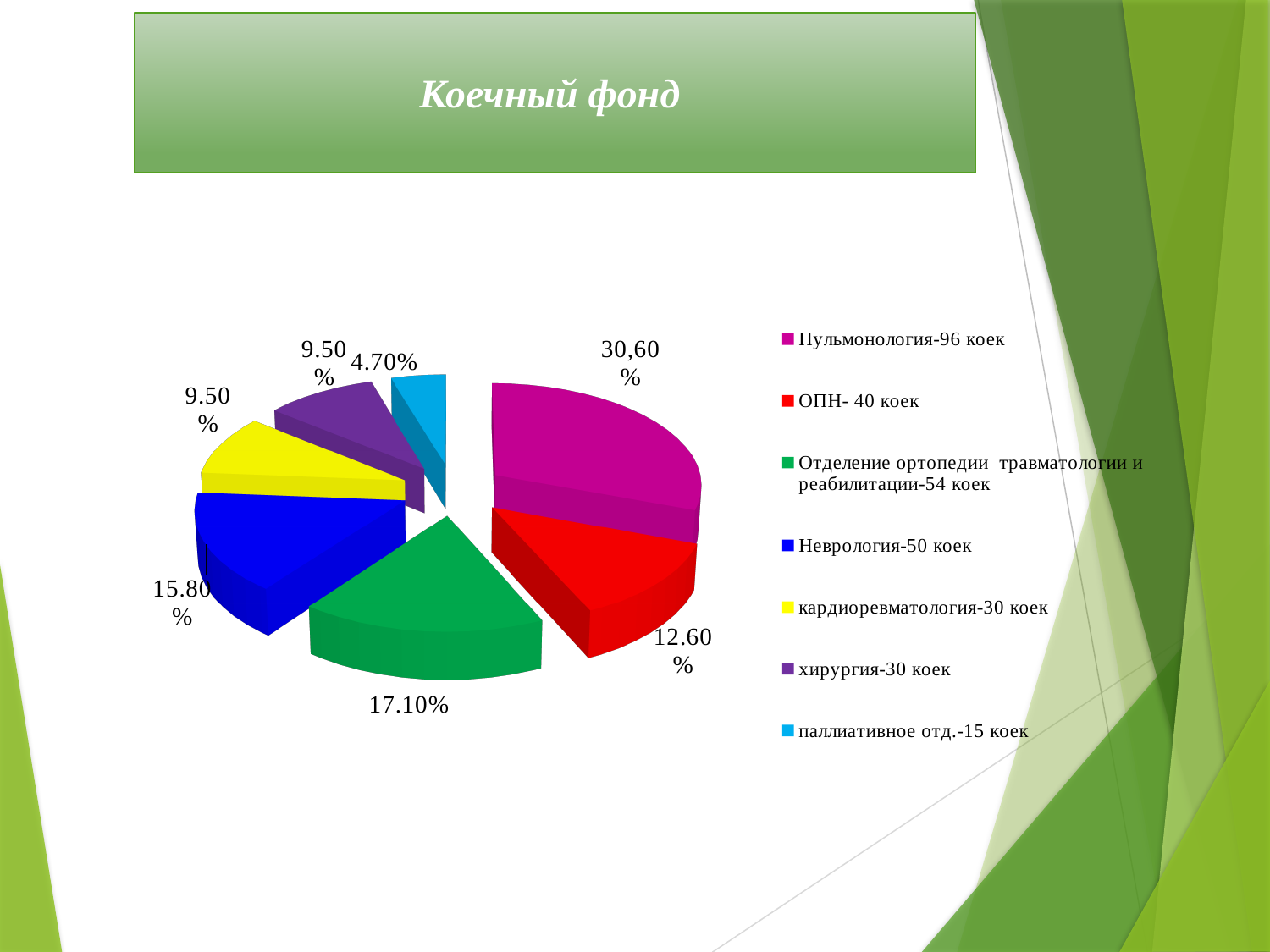
Which category has the largest slice of the pie? Пульмонология-96 коек How many slices does the pie chart have? 7 What is the title of the slide with the chart? Коечный фонд What share of the pie does Пульмонология-96 коек have? 30,60% How many entries does the legend list? 7 What type of chart is shown on the slide? pie chart Which category has the smallest slice of the pie? паллиативное отд.-15 коек What is the value shown for ОПН- 40 коек? 12.60% What is the difference between the shares of Отделение ортопедии травматологии и реабилитации-54 коек and Неврология-50 коек? 1.30% What is the value shown for Неврология-50 коек? 15.80% Which is larger, the share for ОПН- 40 коек or the share for кардиоревматология-30 коек? ОПН- 40 коек What is the value shown for паллиативное отд.-15 коек? 4.70%